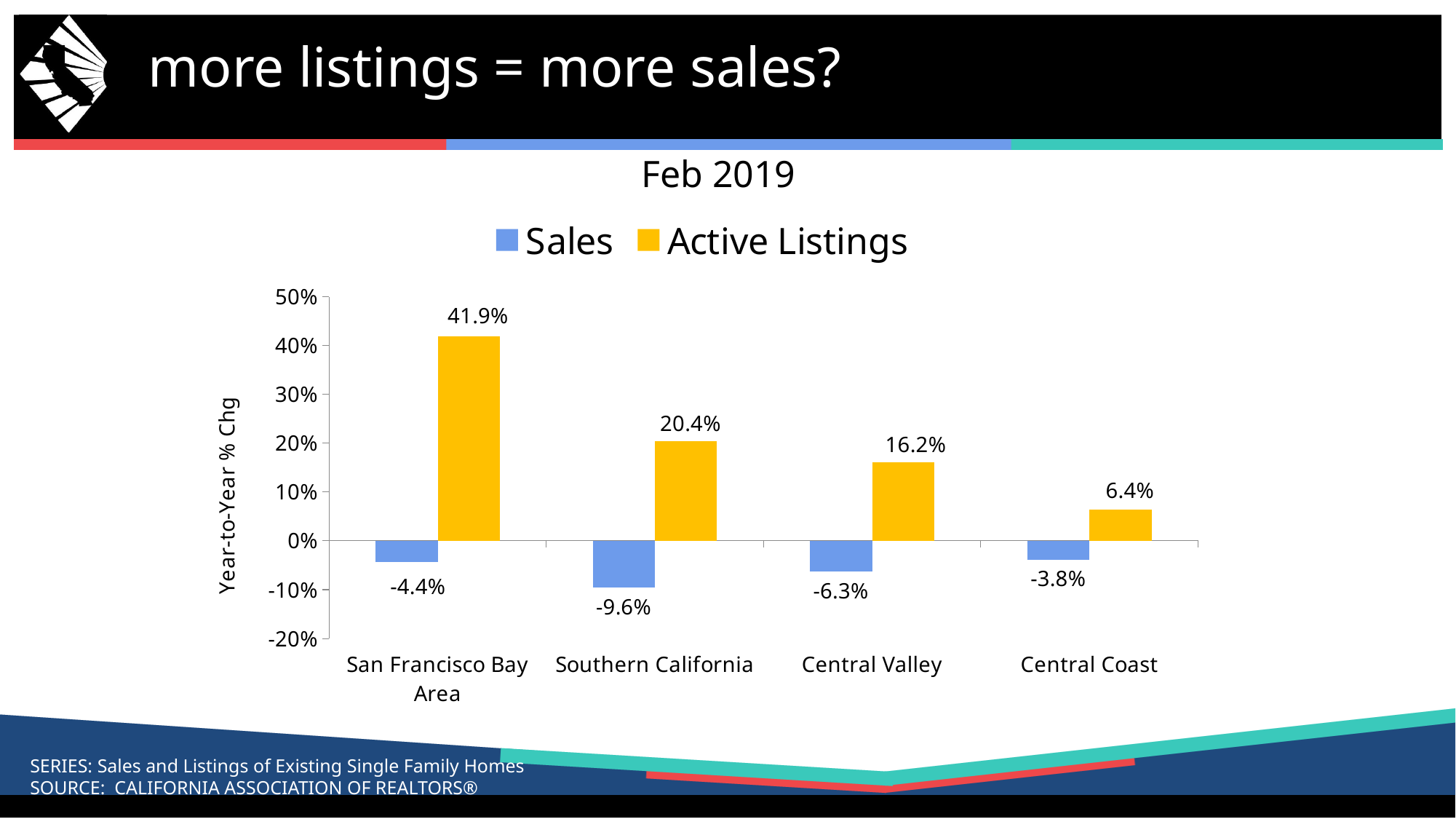
Which region has the highest Active Listings value? San Francisco Bay Area What is the Sales value for Central Coast? -3.8% Which region has the lowest Sales value? Southern California What is the Active Listings value for the San Francisco Bay Area? 41.9% How many series does the legend list? 2 What is the Sales value for Southern California? -9.6% What is the title of the chart? Feb 2019 Which is larger, the Sales value for Central Valley or the Sales value for San Francisco Bay Area? San Francisco Bay Area What kind of chart is shown on the slide? Bar chart How many regions are shown on the x axis? 4 What is the Active Listings value for Central Valley? 16.2% What is the difference between the Active Listings values for Southern California and Central Coast? 14.0%